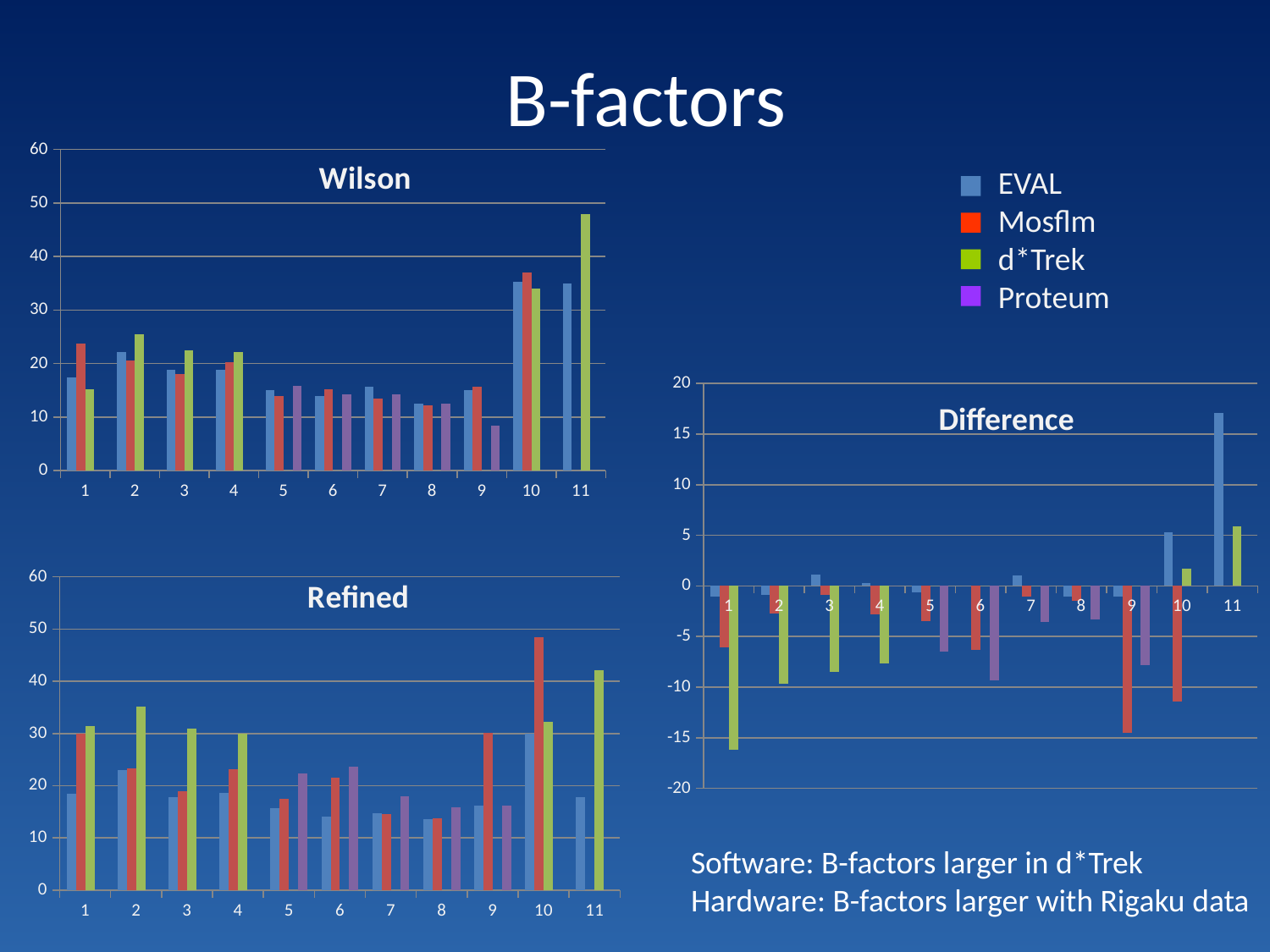
In the Refined chart, is the d*Trek value for category 11 greater or less than 40? greater In the Wilson chart, is the Proteum value for category 9 greater or less than 10? less In the Wilson chart, which series has the highest bar at category 11? d*Trek In the Wilson chart, is the d*Trek value for category 11 greater or less than 40? greater In the Difference chart, which category has the highest bar overall? 11 Which series is shown in green in the legend? d*Trek What kind of chart is the Wilson chart? bar chart In the Refined chart, which is larger at category 2: the Mosflm value or the d*Trek value? d*Trek How many categories are shown on the x axis of the Refined chart? 11 How many series does the legend list? 4 In the Refined chart, which series has the highest bar at category 10? Mosflm